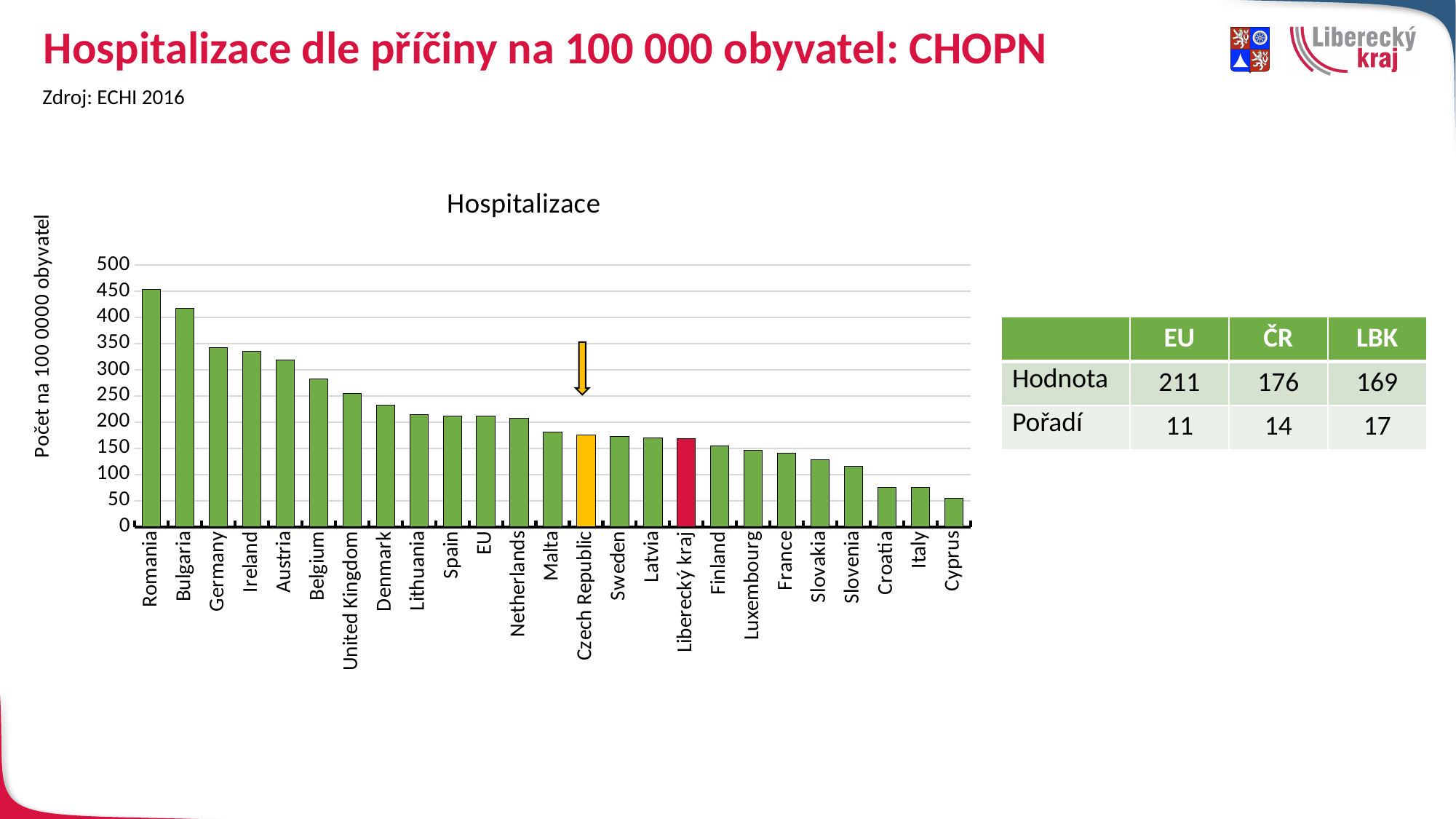
Which country has the lowest hospitalization value in the chart? Cyprus According to the table on the slide, what is the difference between the EU value and the ČR value? 35 Do the values rise or fall moving from left to right along the x axis? fall Which country has the highest hospitalization value in the chart? Romania Which is larger, the value for Bulgaria or the value for Germany? Bulgaria What is the title of the chart? Hospitalizace Is the value for Romania greater or less than 400? greater Is the value for Germany greater or less than 300? greater What kind of chart is shown on the slide? bar chart Is the value for Cyprus greater or less than 100? less According to the table on the slide, what is the value (Hodnota) for EU? 211 How many bars (categories) are plotted in the chart? 25